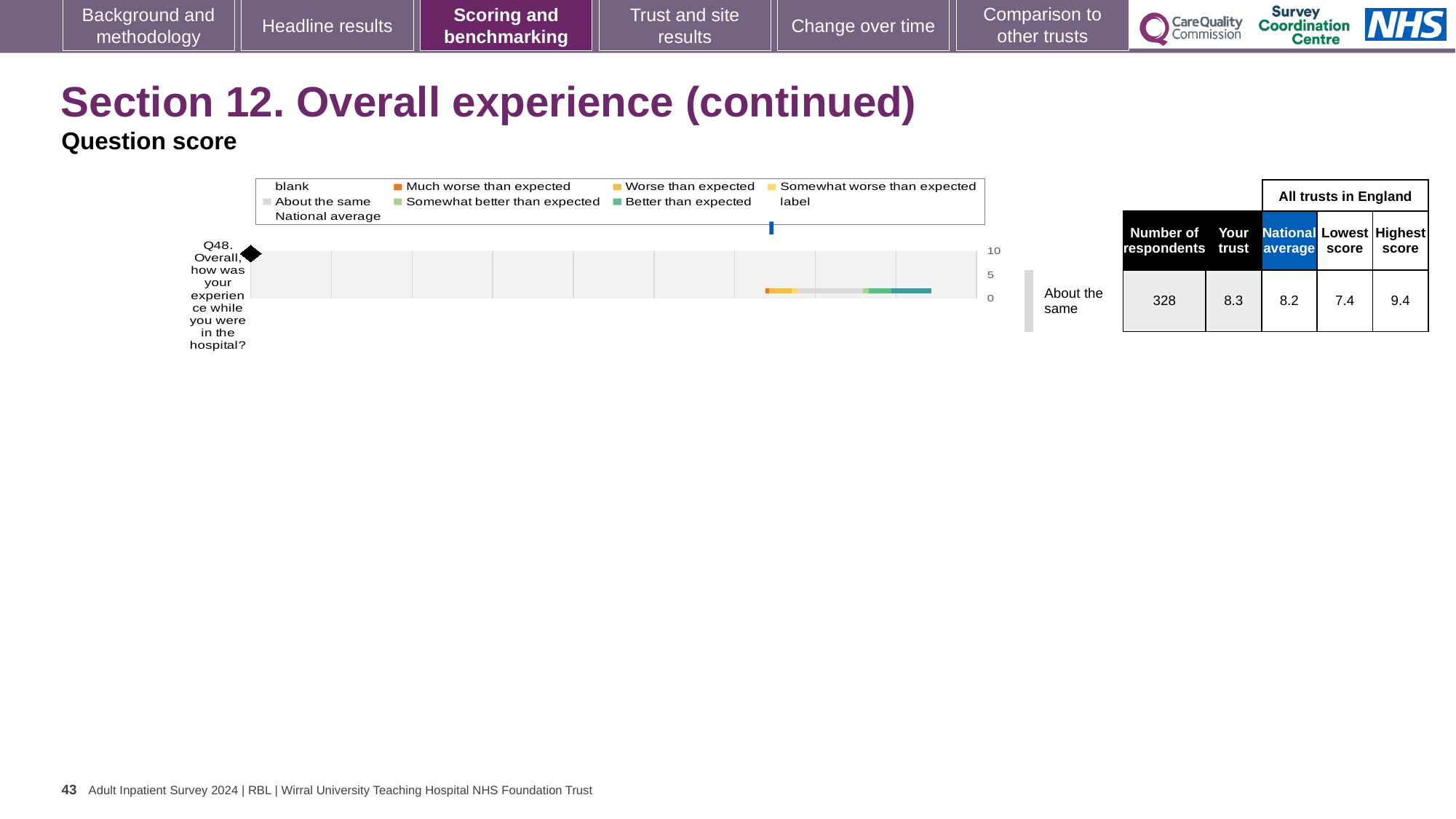
What is the lowest score among all trusts in England for Q48? 7.4 What benchmark category is shown next to the chart for Q48? About the same What is the highest score among all trusts in England for Q48? 9.4 What is the 'Your trust' score for Q48? 8.3 Which is larger for Q48, the 'Your trust' score or the national average? Your trust Which question is plotted in the chart? Q48. Overall, how was your experience while you were in the hospital? How many questions are plotted in the chart? 1 What kind of chart is shown on the slide? bar chart How many respondents answered Q48? 328 What is the highest value shown on the chart's axis? 10 What is the national average score for Q48? 8.2 What is the difference between the highest and lowest scores among all trusts in England for Q48? 2.0